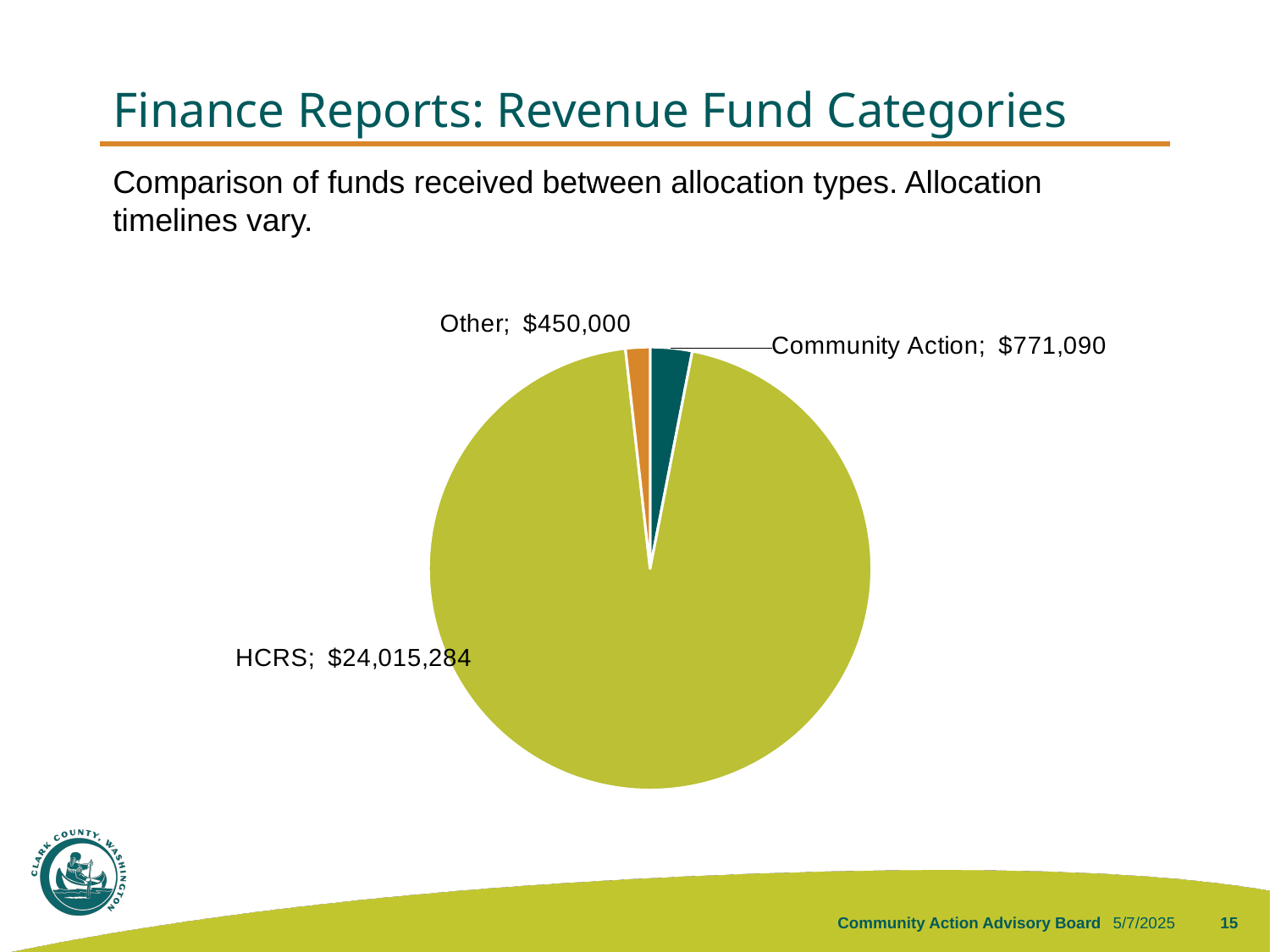
What is the total of all three slices in the pie chart? $25,236,374 What is the value for Other? $450,000 What type of chart is shown on the slide? Pie chart What is the difference between the Community Action and Other values? $321,090 How many slices does the pie chart have? 3 What colour is the HCRS slice of the pie? Yellow-green What is the difference between the HCRS and Community Action values? $23,244,194 What is the value for Community Action? $771,090 Which category has the largest slice of the pie? HCRS What is the value for HCRS? $24,015,284 Which is larger, Community Action or Other? Community Action Which category has the smallest slice of the pie? Other